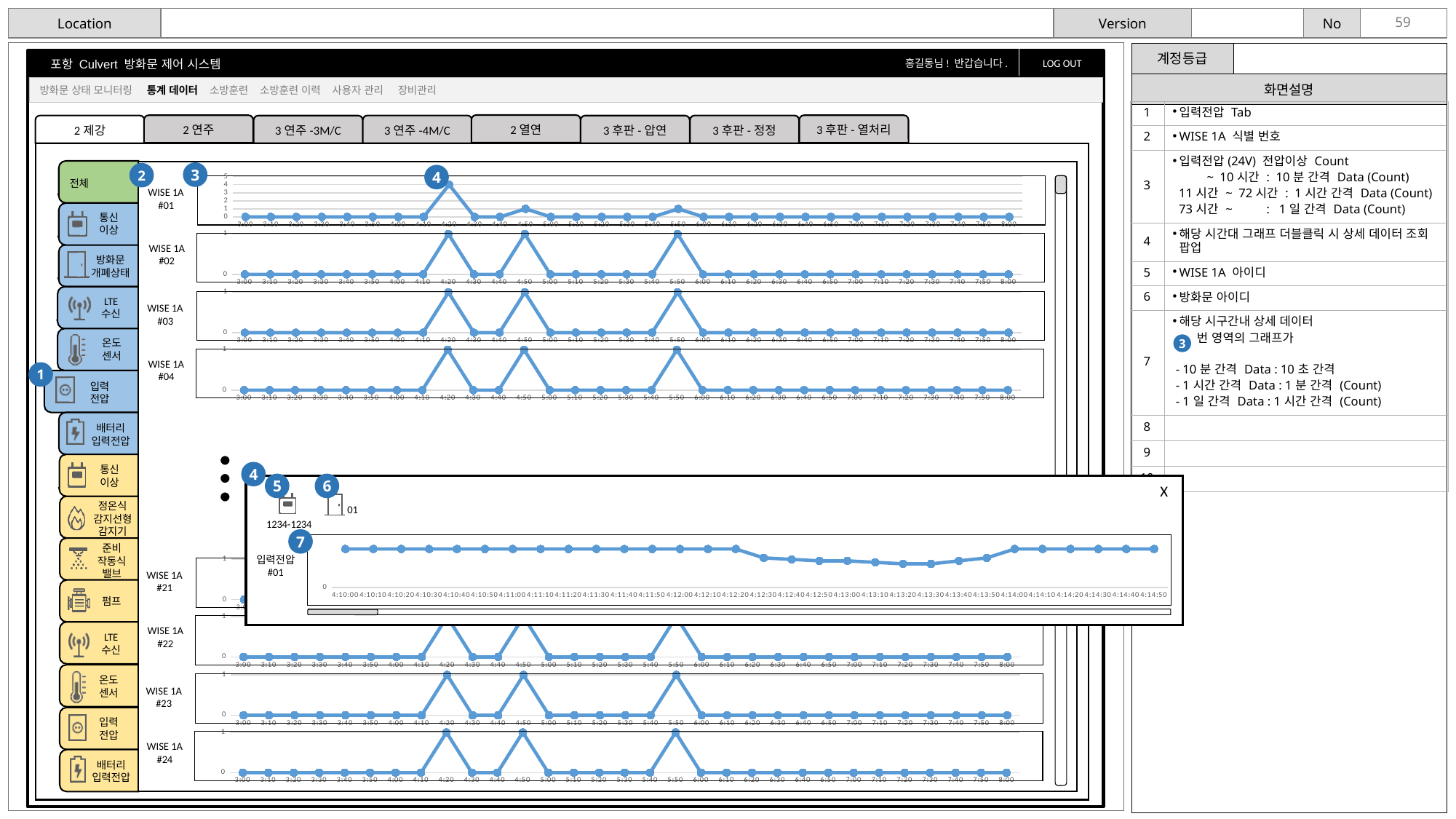
What is the highest tick value shown on the y axis of the WISE 1A #01 chart? 5 In the WISE 1A #02 chart, how many peaks rise above the baseline? 3 In the WISE 1A #01 chart, is the value at 4:20 greater or less than 3? greater In the WISE 1A #01 chart, at which time label does the line reach its highest value? 4:20 What kind of chart is shown in the popup labelled 입력전압 #01? line chart What is the first time label on the x axis of the popup chart labelled 입력전압 #01? 4:10:00 What is the first time label on the x axis of the WISE 1A #02 chart? 3:00 In the WISE 1A #01 chart, is the value at 4:50 greater or less than 3? less In the WISE 1A #02 chart, which is larger, the value at 4:20 or the value at 4:30? 4:20 What is the last time label on the x axis of the WISE 1A #02 chart? 8:00 What kind of chart is used for the WISE 1A #01 panel? line chart In the popup chart labelled 입력전압 #01, which is larger, the value at 4:10:00 or the value at 4:13:00? 4:10:00